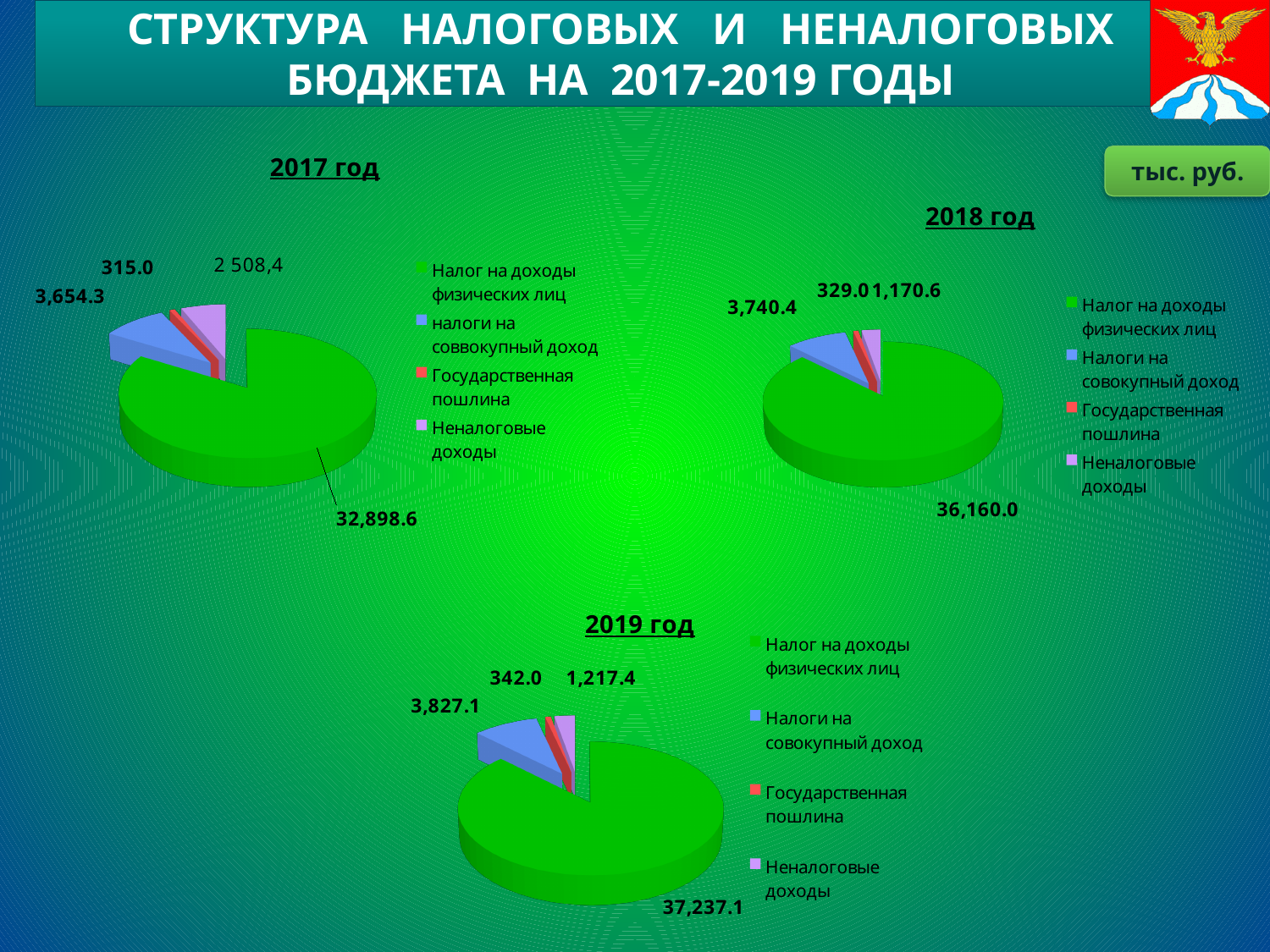
In the 2018 год pie chart, which is larger: Налоги на совокупный доход or Неналоговые доходы? Налоги на совокупный доход In the 2018 год pie chart, which category has the smallest value? Государственная пошлина In the 2019 год pie chart, which category has the largest slice? Налог на доходы физических лиц In the 2018 год pie chart, what is the value for Неналоговые доходы? 1,170.6 What unit of measurement is shown on the slide for the chart values? тыс. руб. In the 2019 год pie chart, what is the value for Налоги на совокупный доход? 3,827.1 What is the total of all four values in the 2019 год pie chart? 42,623.6 What is the difference between the Налог на доходы физических лиц value in the 2019 год chart and in the 2018 год chart? 1,077.1 What type of chart is used for 2019 год? Pie chart How many slices does the 2017 год pie chart have? 4 In the 2017 год pie chart, what is the value for Государственная пошлина? 315.0 In the 2017 год pie chart, what is the value for Налог на доходы физических лиц? 32,898.6